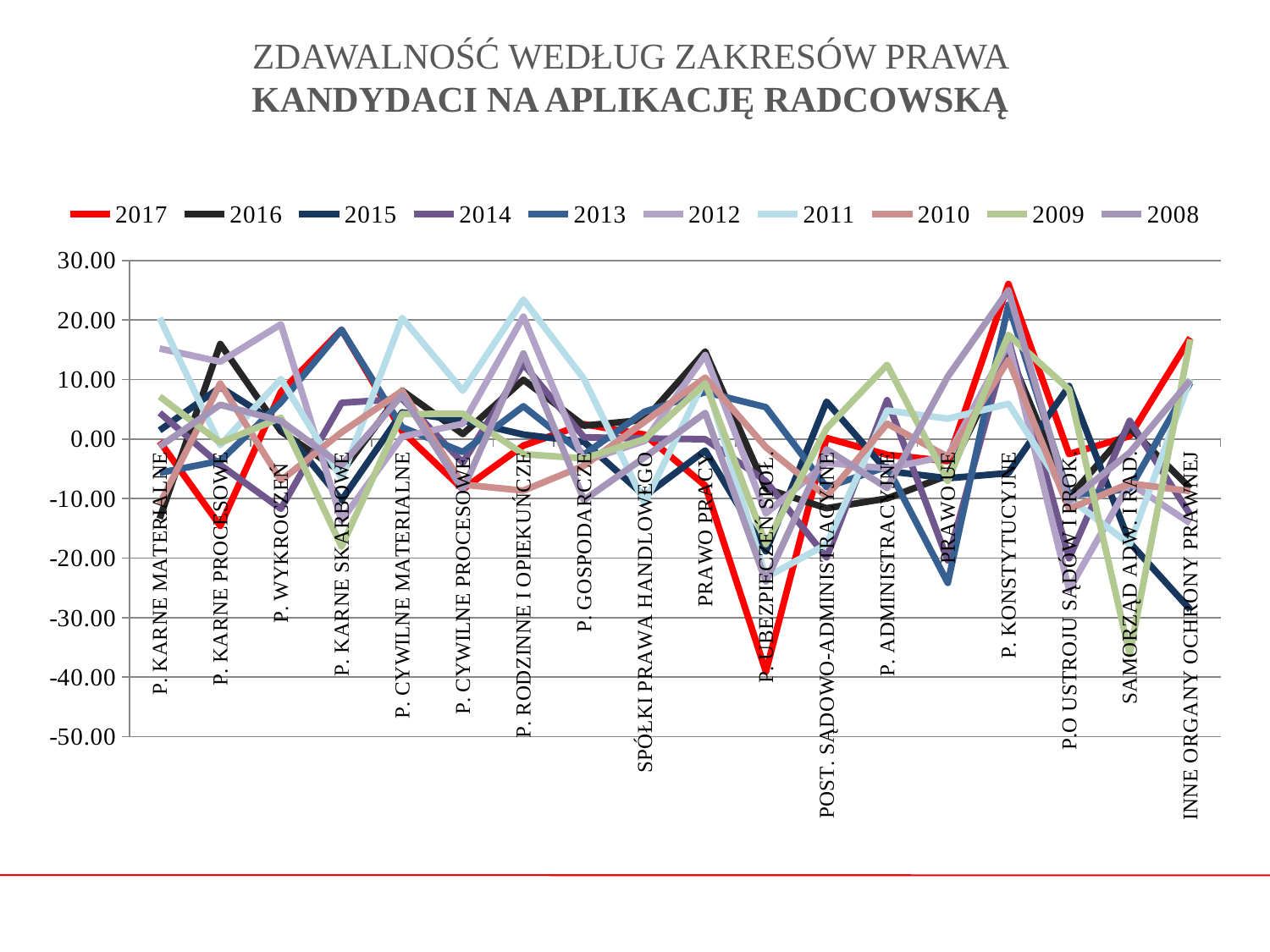
Is the value for 2013 at PRAWO UE greater or less than -20? less How many series does the legend list? 10 Is the value for 2009 at SAMORZĄD ADW. I RADC. greater or less than -30? less What colour is the 2017 series line in the legend? red What kind of chart is shown on the slide? line chart For the 2017 series, which category has the lowest value? P. UBEZPIECZEŃ SPOŁ. Is the value for 2017 at P. UBEZPIECZEŃ SPOŁ. greater or less than -30? less For the 2017 series, which category has the highest value? P. KONSTYTUCYJNE How many categories are shown along the x axis? 18 Which is larger: the 2017 value at P. KONSTYTUCYJNE or the 2017 value at P. UBEZPIECZEŃ SPOŁ.? P. KONSTYTUCYJNE